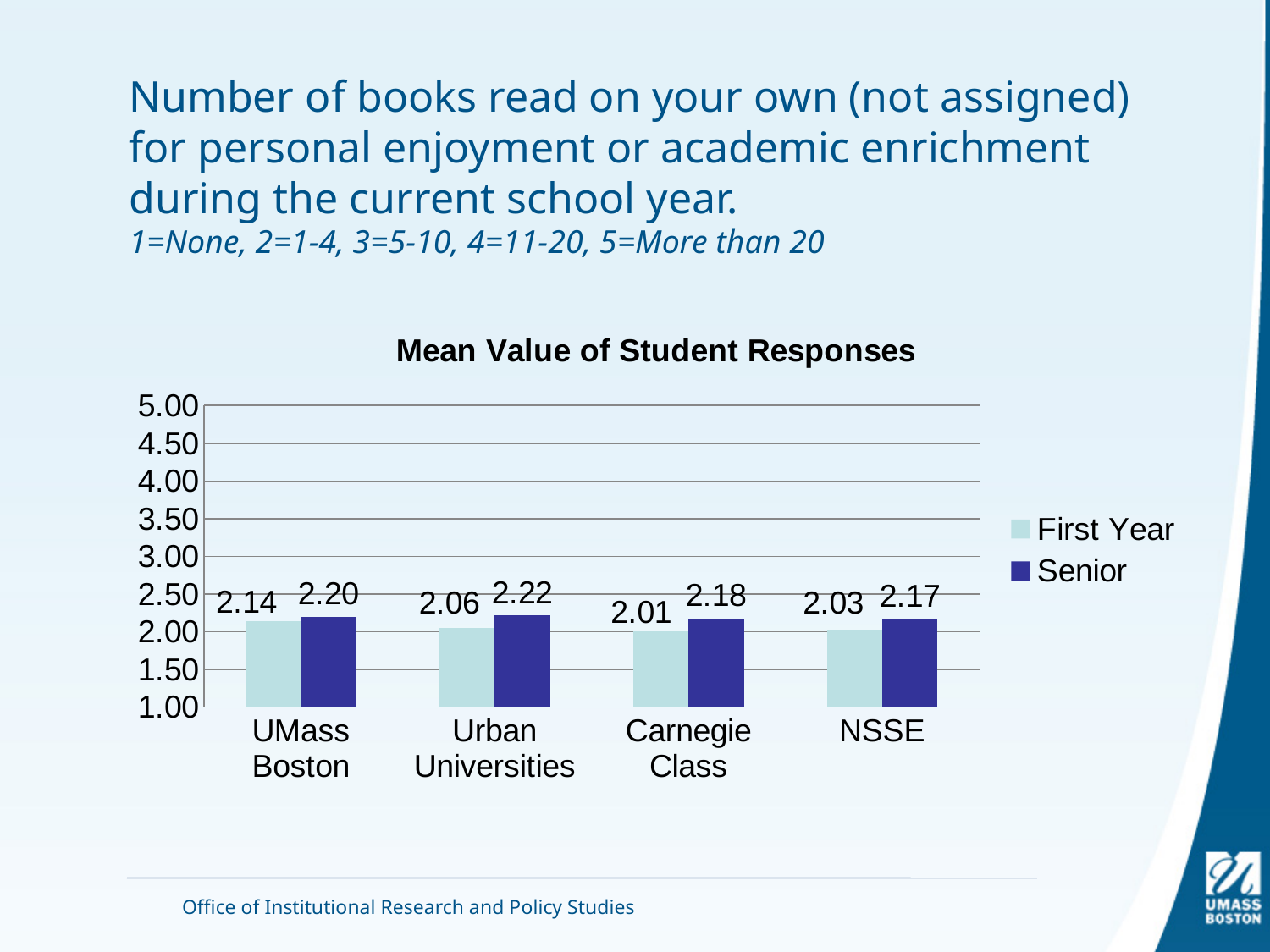
What is the difference between the Senior and First Year values for Carnegie Class? 0.17 Which category has the highest Senior value? Urban Universities How many series does the legend list? 2 What kind of chart is shown? bar chart What is the Senior value for Urban Universities? 2.22 What is the First Year value for UMass Boston? 2.14 What is the First Year value for Carnegie Class? 2.01 Is the Senior value for Urban Universities greater or less than 2.50? less Which category has the lowest First Year value? Carnegie Class How many categories are shown on the x axis? 4 What is the Senior value for NSSE? 2.17 Which is larger for UMass Boston, the First Year value or the Senior value? Senior